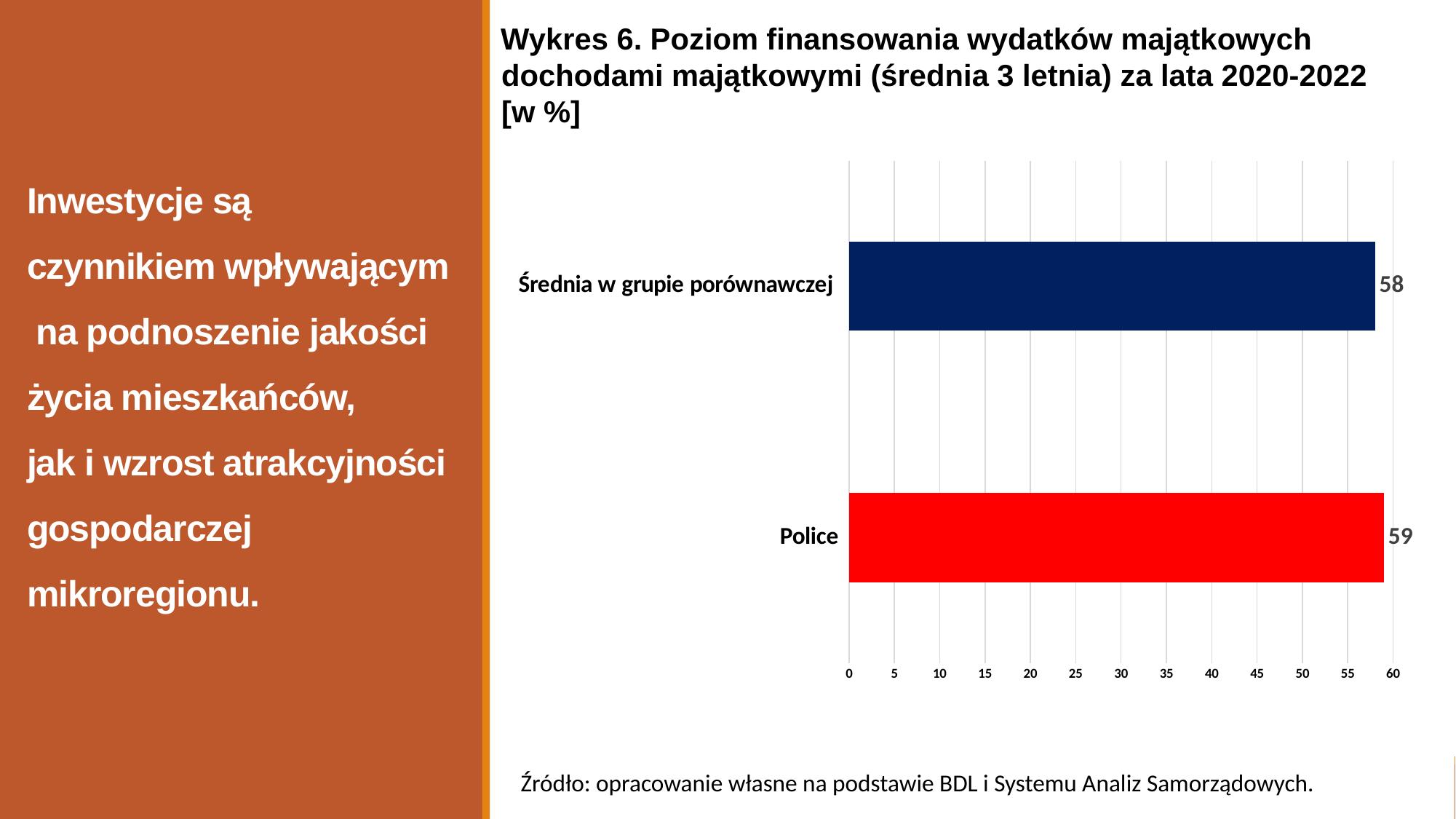
What kind of chart is shown on the slide? bar chart What is the difference between the value for Police and the value for Średnia w grupie porównawczej? 1 What is the value for Police? 59 What is the value for Średnia w grupie porównawczej? 58 Is the value for Police greater or less than 50? greater What is the maximum value shown on the horizontal axis? 60 Is the value for Średnia w grupie porównawczej greater or less than 60? less How many categories are shown in the chart? 2 What colour is the bar for Police? red Which is larger, the value for Police or the value for Średnia w grupie porównawczej? Police Which category has the lowest value? Średnia w grupie porównawczej Which category has the highest value? Police